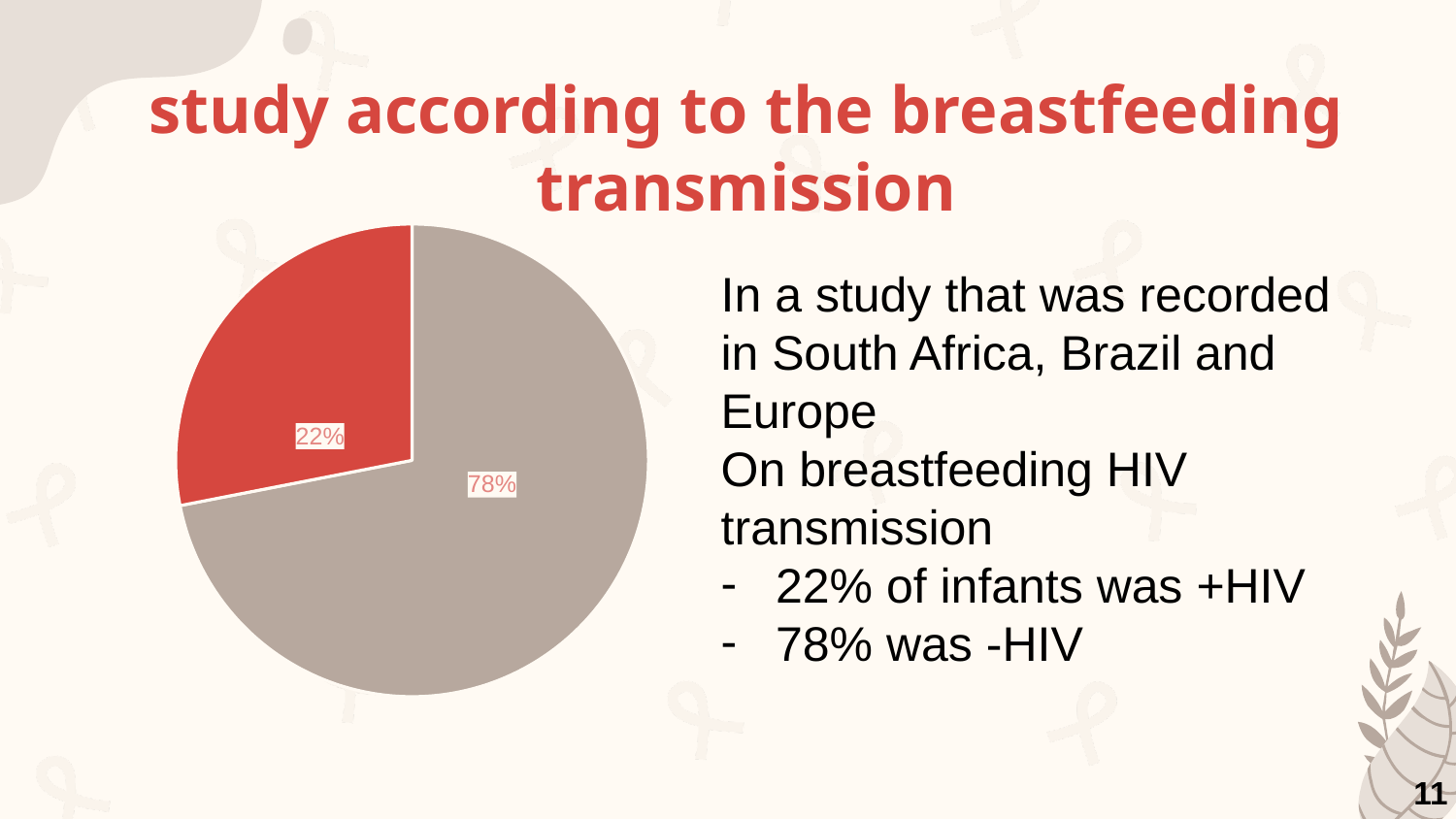
What value is labelled on the red slice of the pie chart? 22% What do the two slice values of the pie chart add up to? 100% What colour is the slice labelled 22%? Red Which slice of the pie chart is larger, the red one or the grey one? The grey one How many slices does the pie chart have? 2 What kind of chart is shown on the slide? Pie chart What share of the pie does the red slice represent? 22% What is the value of the smallest slice of the pie chart? 22% What is the difference between the two slice values in the pie chart? 56 percentage points Is the value of the grey slice greater or less than 50%? greater What is the value of the largest slice of the pie chart? 78% What value is labelled on the grey slice of the pie chart? 78%